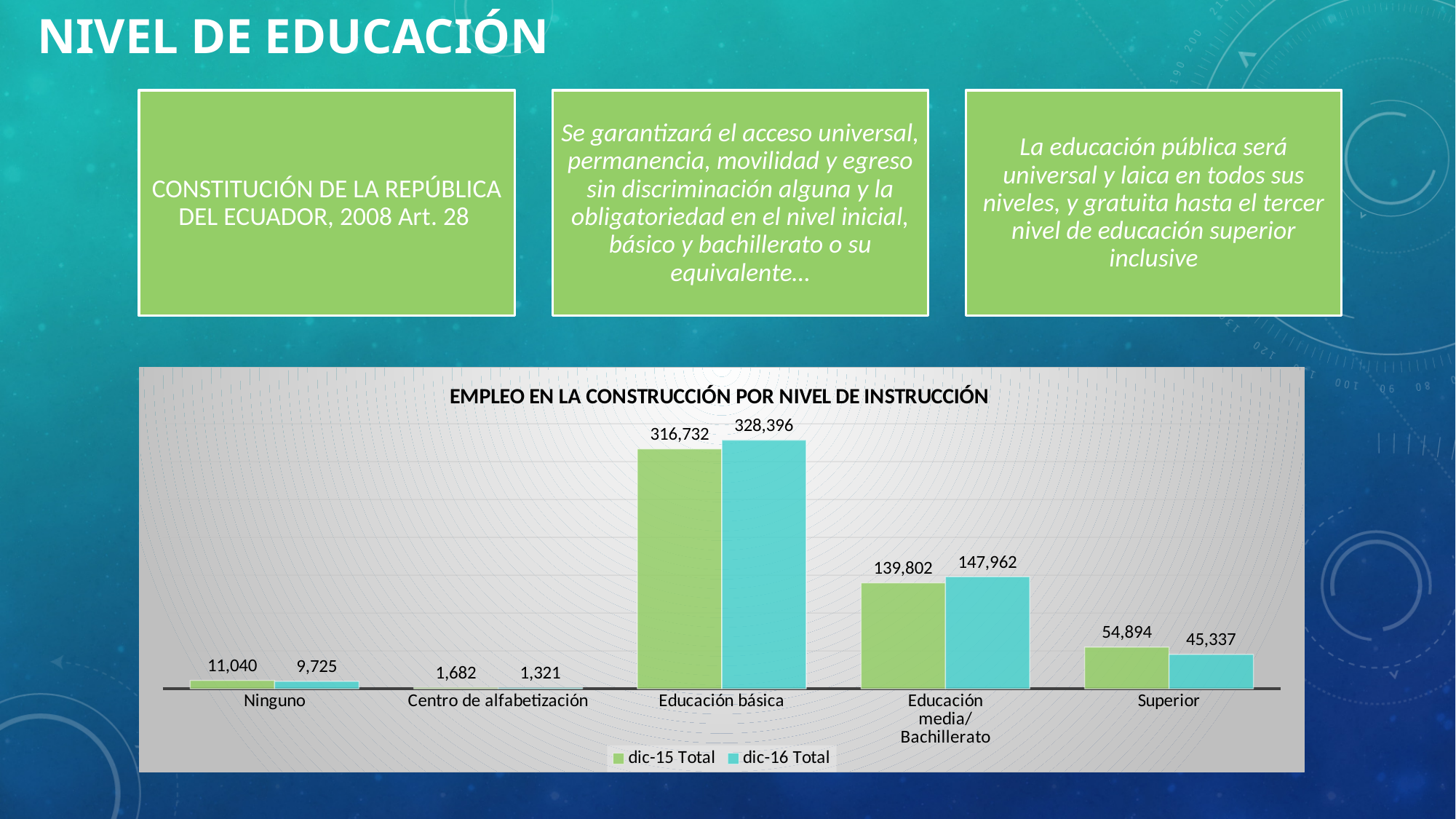
How many categories are shown on the x axis of the chart? 5 What is the dic-16 Total value for Superior? 45,337 What is the dic-15 Total value for Educación básica? 316,732 Which category has the lowest dic-15 Total value? Centro de alfabetización What is the difference between the dic-16 Total and dic-15 Total values for Educación básica? 11,664 What type of chart is shown on the slide? Bar chart What is the dic-16 Total value for Centro de alfabetización? 1,321 For Ninguno, which is larger: the dic-15 Total or the dic-16 Total value? dic-15 Total What is the dic-15 Total value for Educación media/Bachillerato? 139,802 Which category has the highest dic-16 Total value? Educación básica What is the difference between the dic-15 Total and dic-16 Total values for Superior? 9,557 How many series does the chart legend list? 2